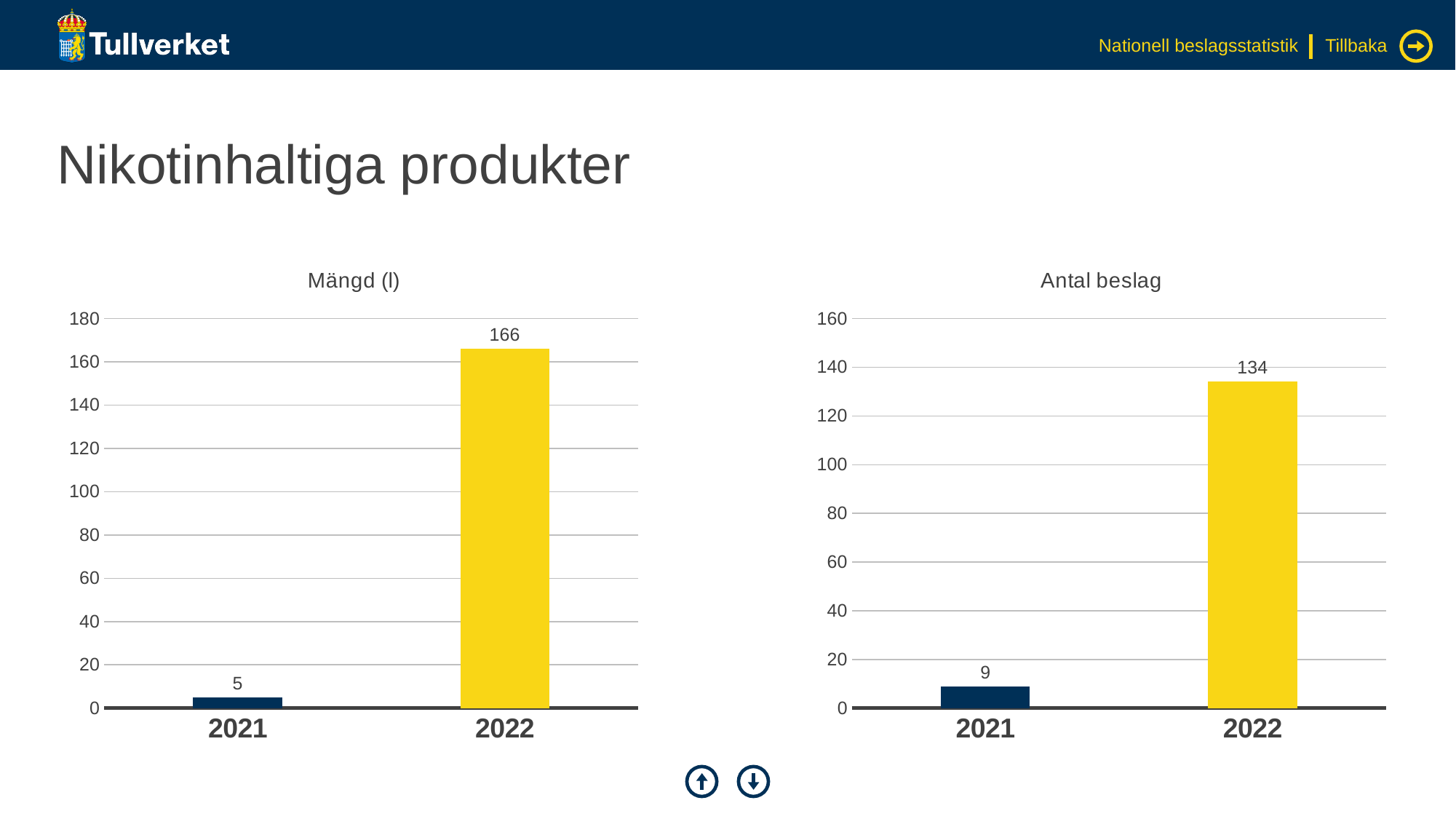
In the 'Antal beslag' chart, what is the value for 2021? 9 In the 'Mängd (l)' chart, do the values rise or fall from 2021 to 2022? rise In the 'Mängd (l)' chart, what is the value for 2022? 166 In the 'Antal beslag' chart, what is the difference between the 2022 and 2021 values? 125 In the 'Mängd (l)' chart, what is the difference between the 2022 and 2021 values? 161 In the 'Antal beslag' chart, which year has the lowest value? 2021 In the 'Antal beslag' chart, what is the value for 2022? 134 In the 'Mängd (l)' chart, which year has the highest value? 2022 In the 'Antal beslag' chart, is the value for 2022 greater or less than 120? greater What kind of chart is the 'Antal beslag' chart? bar chart How many years are shown in the 'Mängd (l)' chart? 2 In the 'Mängd (l)' chart, what is the value for 2021? 5